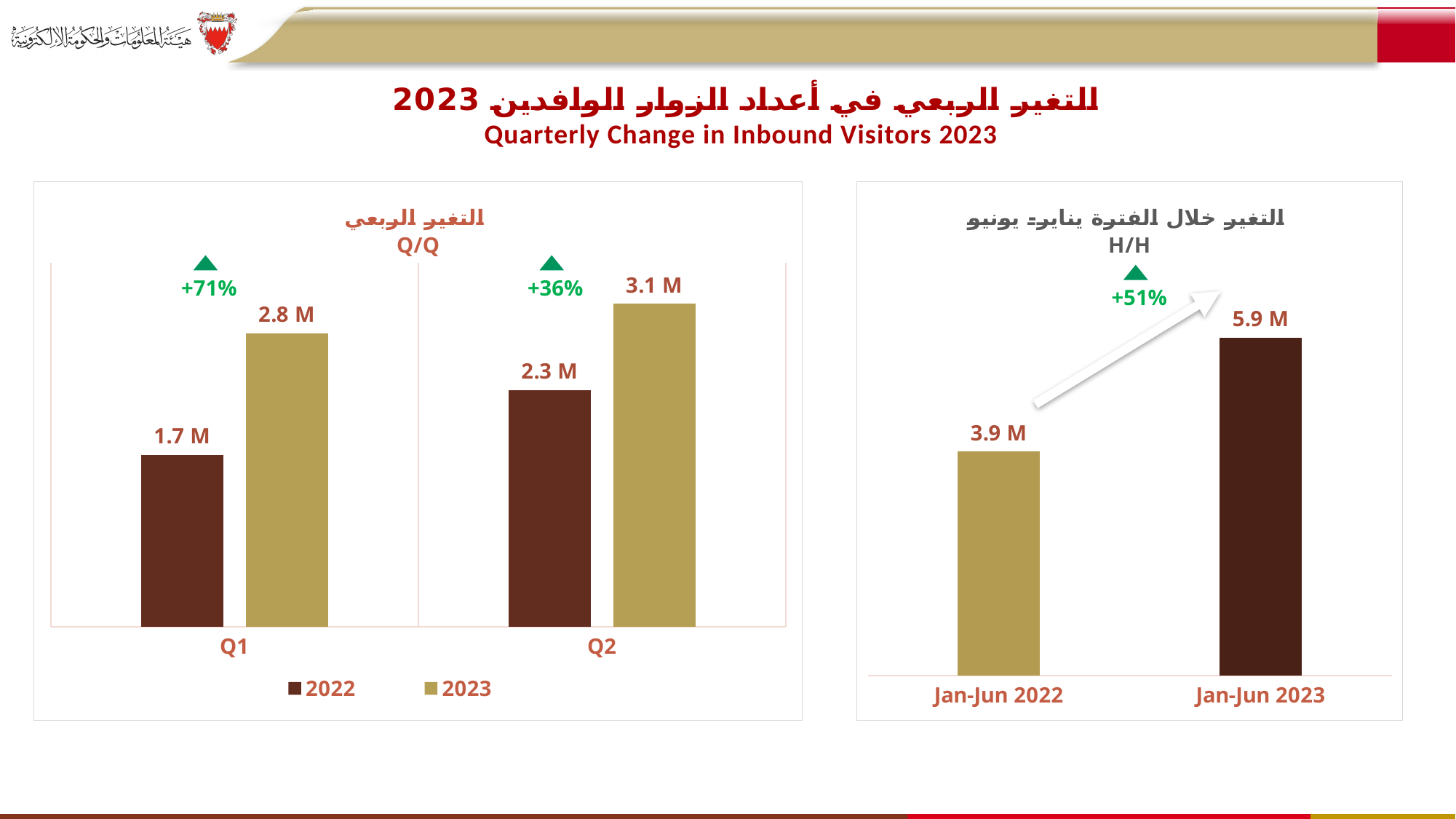
In the Q/Q chart on the left, what kind of chart is it? Bar chart In the Q/Q chart on the left, what is the value for 2023 in Q1? 2.8 M In the H/H chart on the right, what percentage change is shown? +51% In the H/H chart on the right, how many categories are shown on the x axis? 2 In the H/H chart on the right, what is the value for Jan-Jun 2023? 5.9 M In the H/H chart on the right, what is the difference between Jan-Jun 2023 and Jan-Jun 2022? 2.0 M In the Q/Q chart on the left, how many series does the legend list? 2 In the Q/Q chart on the left, what is the value for 2022 in Q2? 2.3 M In the Q/Q chart on the left, which bar is the highest? 2023 in Q2 In the Q/Q chart on the left, what is the value for 2022 in Q1? 1.7 M In the Q/Q chart on the left, what is the difference between the 2023 and 2022 values in Q1? 1.1 M In the Q/Q chart on the left, what is the percentage change shown for Q2? +36%